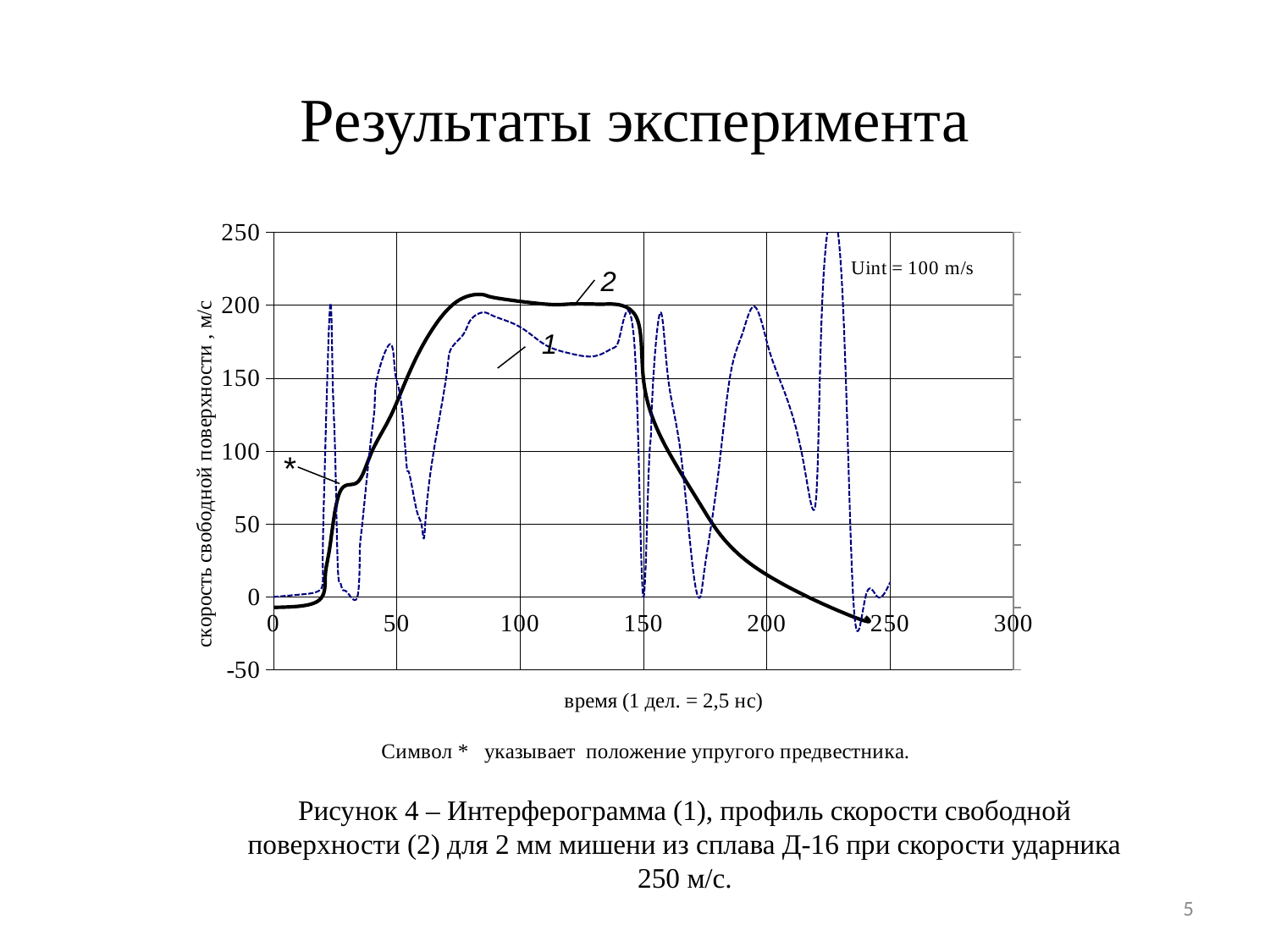
Does curve 2 (solid line) rise or fall between x = 150 and x = 250? fall Is the value of curve 2 (solid line) at x = 10 greater or less than 50? less Is the value of curve 2 (solid line) at x = 200 greater or less than 50? less What is the label of the x axis of the chart? время (1 дел. = 2,5 нс) Does curve 2 (solid line) rise or fall between x = 25 and x = 75? rise What is the highest value shown on the y axis of the chart? 250 How many curves are plotted on the chart? 2 Is the value of curve 2 (solid line) at x = 50 greater or less than 100? greater What is the label of the y axis of the chart? скорость свободной поверхности, м/с What kind of chart is shown on the slide? line chart